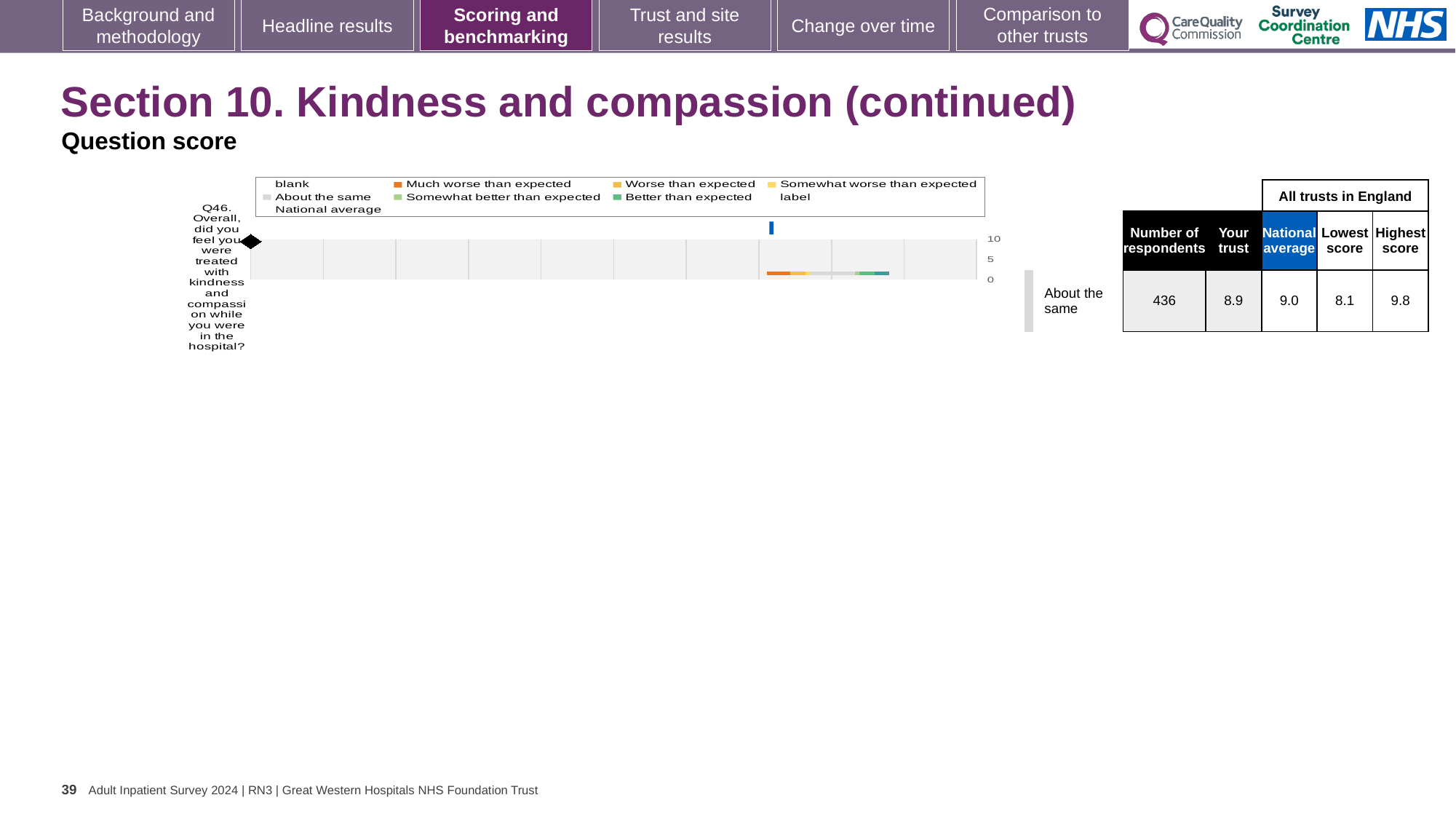
What is the highest score among all trusts in England for Q46? 9.8 What is the number of respondents for Q46 shown in the table? 436 What is the difference between the national average and the trust's score for Q46? 0.1 What kind of chart is shown on the slide? Bar chart How many questions are plotted on the chart? 1 Which is larger for Q46, the trust's score or the national average? National average How is the trust's result for Q46 categorised relative to other trusts? About the same What is the national average score for Q46? 9.0 What is the difference between the highest score and the lowest score for Q46? 1.7 What is the lowest score among all trusts in England for Q46? 8.1 What is the 'Your trust' score for Q46? 8.9 What is the maximum value shown on the chart's score axis? 10